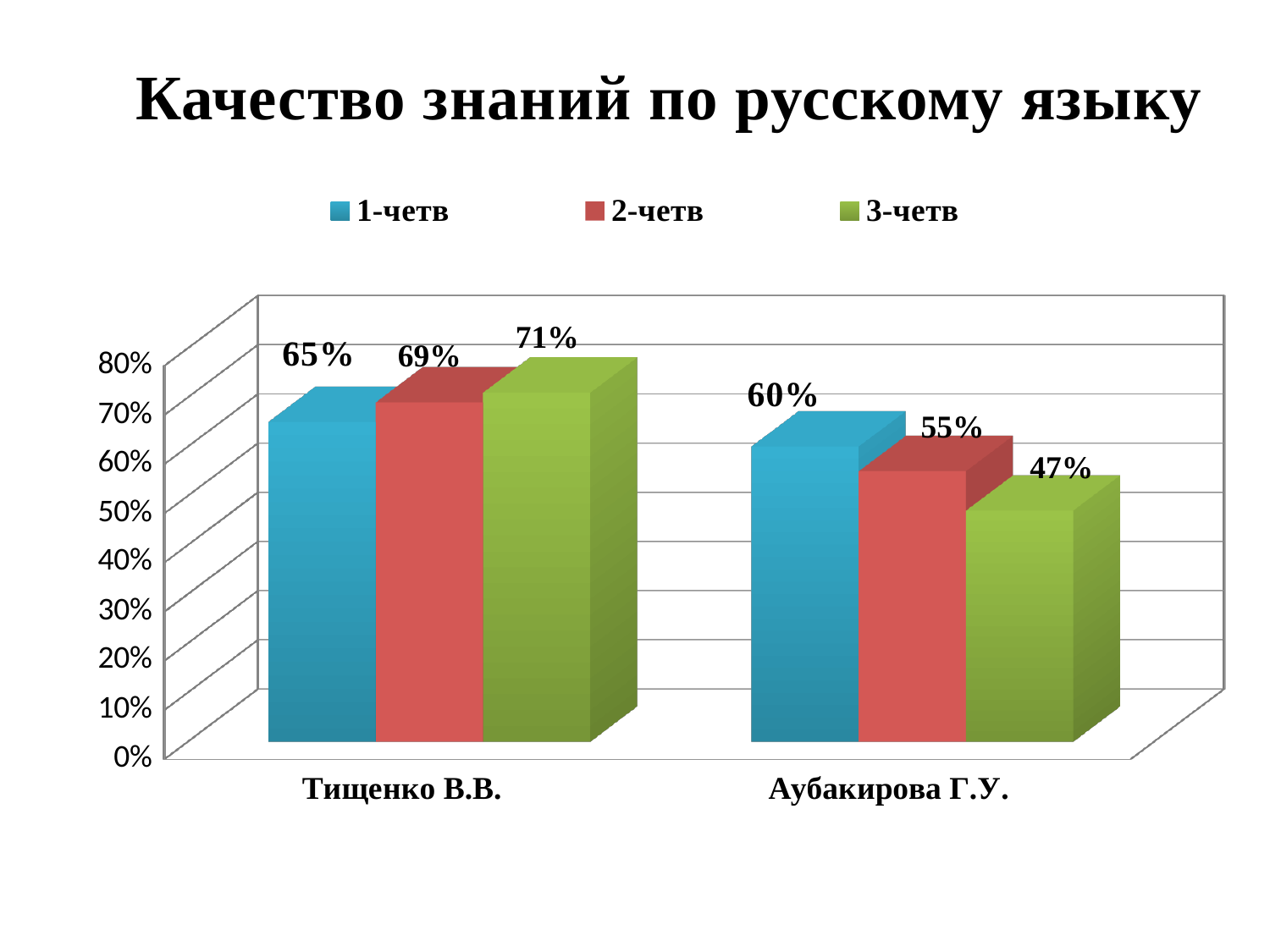
How many series does the legend list? 3 What kind of chart is shown on the slide? Bar chart What is the title of the chart? Качество знаний по русскому языку What is the value for Аубакирова Г.У. in the 3-четв series? 47% Which series has the lowest value for Аубакирова Г.У.? 3-четв What is the difference between the 3-четв values for Тищенко В.В. and Аубакирова Г.У.? 24% Do the values for Аубакирова Г.У. rise or fall from 1-четв to 3-четв? Fall How many categories are shown on the x axis? 2 What is the value for Тищенко В.В. in the 1-четв series? 65% What is the value for Аубакирова Г.У. in the 2-четв series? 55% Which is larger: the 1-четв value for Тищенко В.В. or the 1-четв value for Аубакирова Г.У.? Тищенко В.В. Which teacher has the highest value in the 3-четв series? Тищенко В.В.